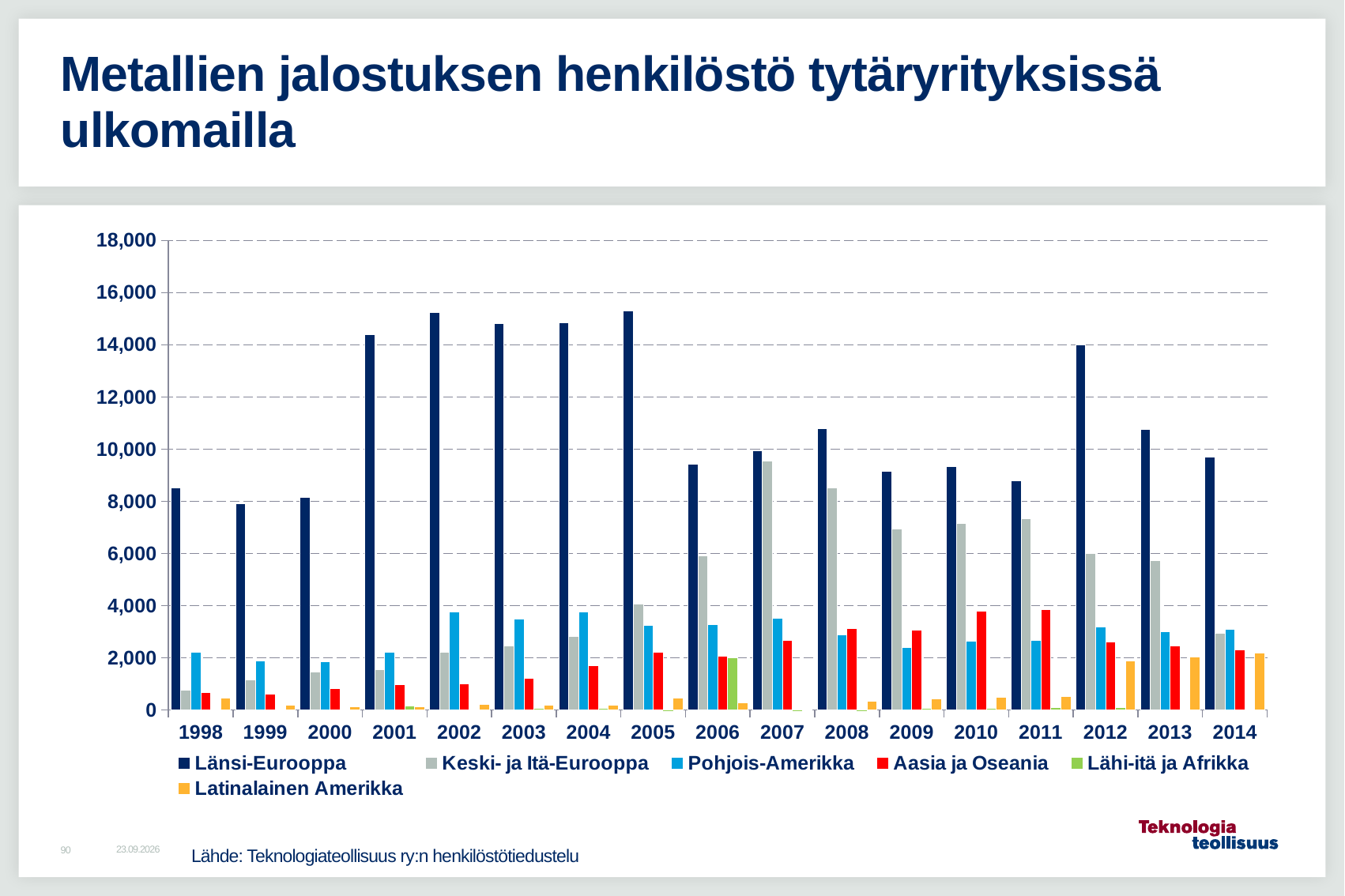
What kind of chart is shown on the slide? bar chart How many years are shown on the x axis? 17 Is the value for Latinalainen Amerikka in 2014 greater or less than 1,000? greater Is the value for Aasia ja Oseania in 2011 greater or less than 2,000? greater Which colour represents Aasia ja Oseania in the legend? red In which year is the value for Keski- ja Itä-Eurooppa highest? 2007 In 2008, which is larger: Länsi-Eurooppa or Keski- ja Itä-Eurooppa? Länsi-Eurooppa In 2014, which is larger: Pohjois-Amerikka or Aasia ja Oseania? Pohjois-Amerikka In which year is the value for Lähi-itä ja Afrikka highest? 2006 Is the value for Keski- ja Itä-Eurooppa in 2007 greater or less than 8,000? greater How many series does the legend list? 6